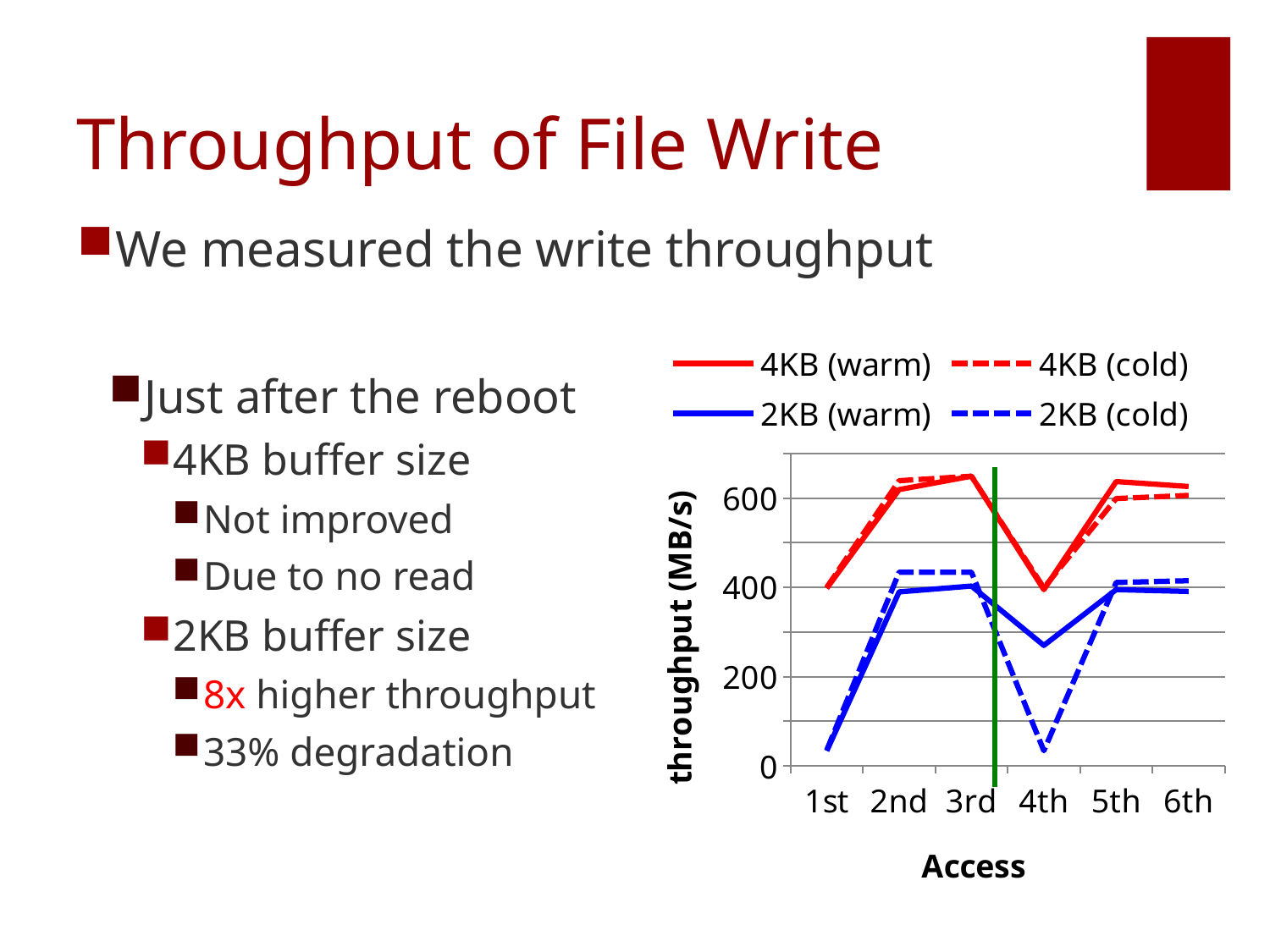
Is the value for 2KB (warm) at the 1st access greater or less than 200? less Is the value for 2KB (cold) at the 4th access greater or less than 200? less Is the value for 2KB (warm) at the 4th access greater or less than 400? less What is the label of the y axis? throughput (MB/s) What kind of chart is shown on the slide? line chart At which access is the 2KB (warm) throughput lowest? 1st Does the 4KB (warm) throughput rise or fall from the 3rd access to the 4th access? fall How many access categories are shown along the x axis? 6 At the 4th access, which is larger: 2KB (warm) or 2KB (cold)? 2KB (warm) How many series does the chart legend list? 4 At the 1st access, which is larger: 4KB (warm) or 2KB (warm)? 4KB (warm)